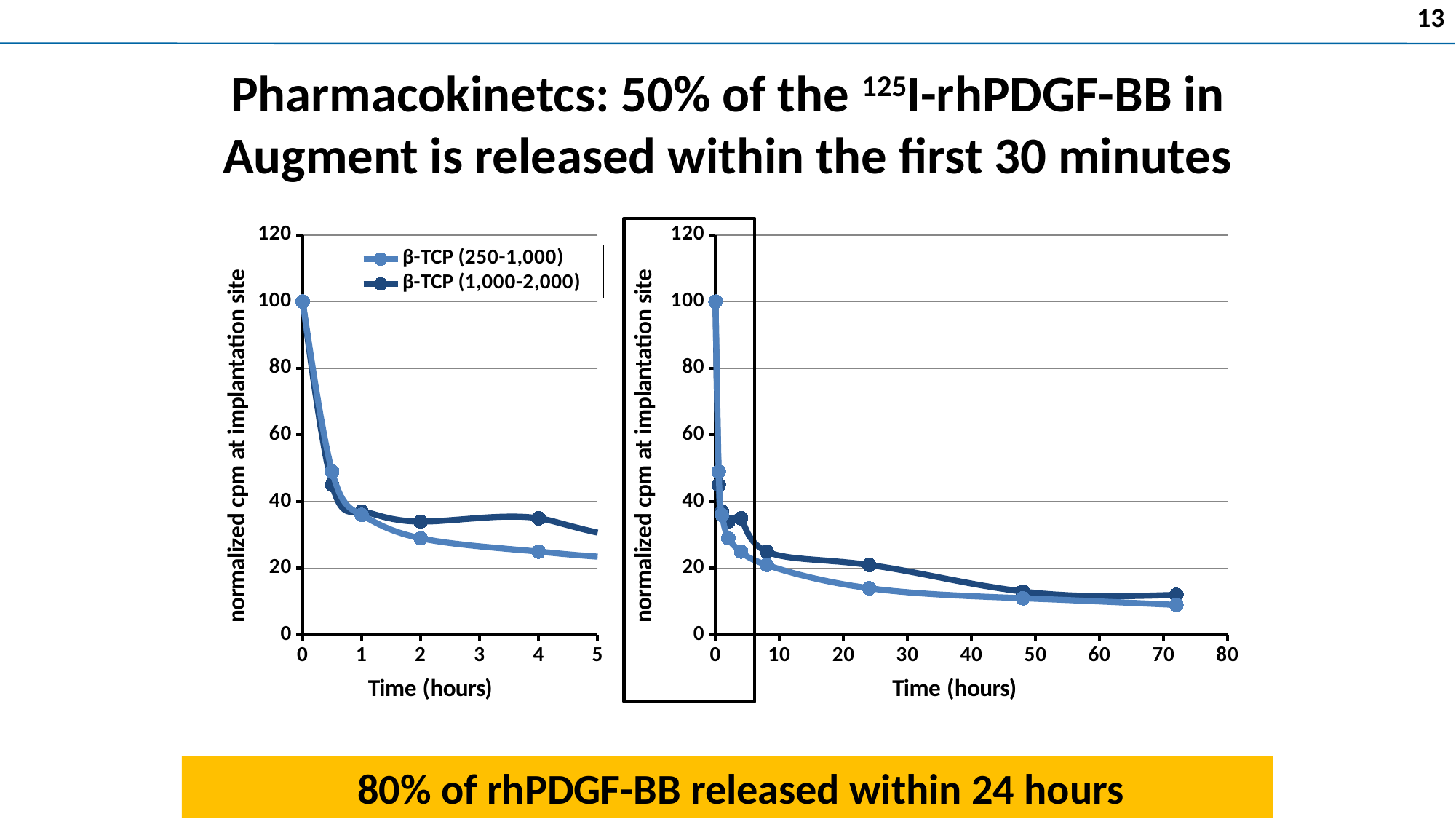
On the left chart, is the value for β-TCP (250-1,000) at 4 hours greater or less than 40? less What kind of chart is the left chart (Time 0–5 hours)? Line chart On the right chart, what is the value for β-TCP (1,000-2,000) at time 0 hours? 100 How many series does the legend on the left chart list? 2 On the left chart, at what time does β-TCP (250-1,000) reach its highest value? 0 hours On the left chart, is the value for β-TCP (1,000-2,000) at 4 hours greater or less than 20? greater On the left chart, what is the value for β-TCP (250-1,000) at time 0 hours? 100 On the left chart, which series has the higher value at 4 hours? β-TCP (1,000-2,000) On the left chart, do the values rise or fall as time increases from 0 to 5 hours? Fall On the right chart, which series has the higher value at 24 hours? β-TCP (1,000-2,000) What is the y-axis label on the right chart? normalized cpm at implantation site On the right chart, is the value for β-TCP (250-1,000) at about 72 hours greater or less than 20? less